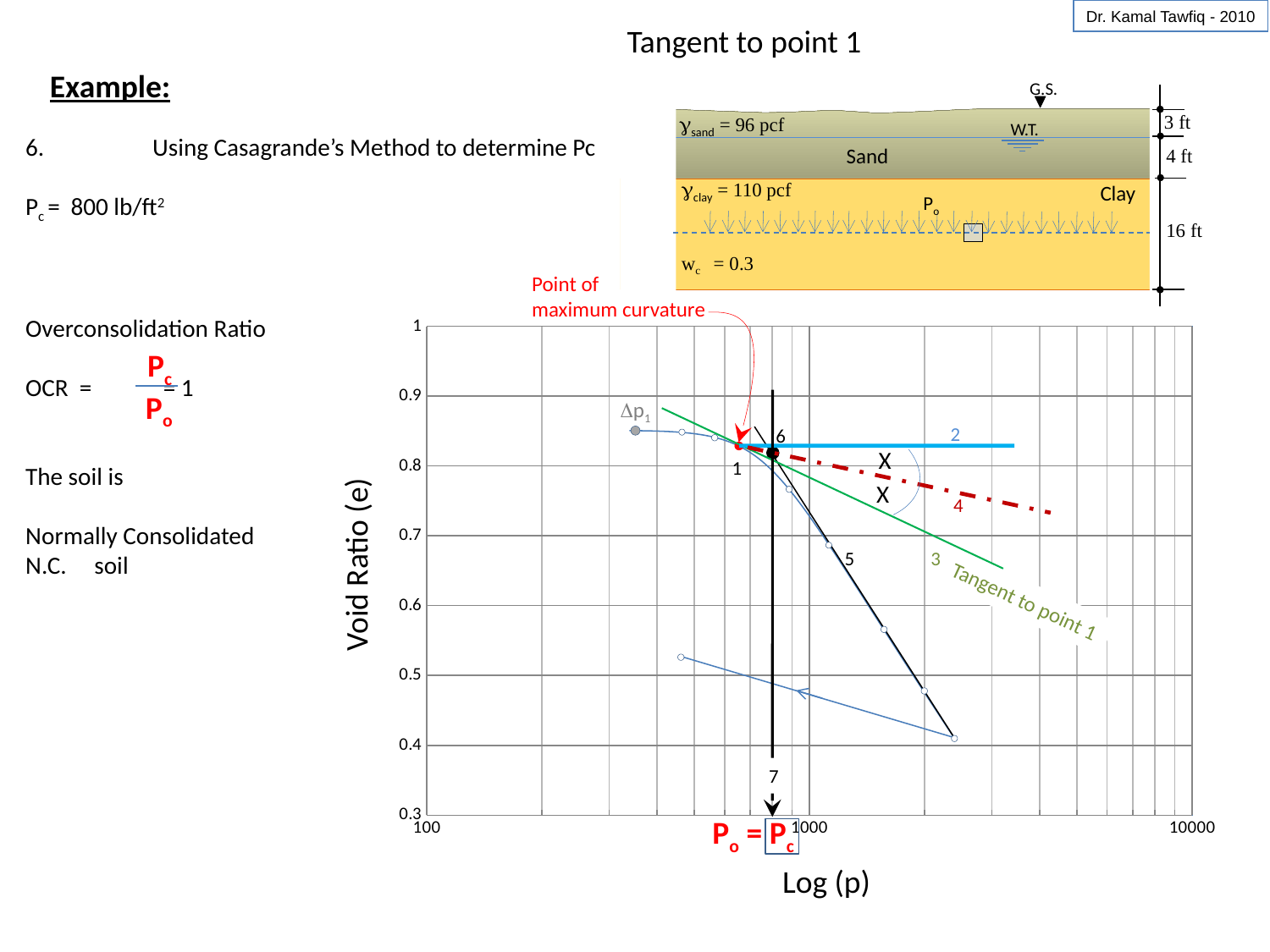
What kind of chart is shown on the slide? line chart Is the void ratio at the point labelled 1 greater or less than 0.9? less Is the void ratio at the point labelled Δp1 greater or less than 0.8? greater Which point has the higher void ratio, the point labelled Δp1 or the point labelled 5? Δp1 Is the void ratio at the lowest point of the loading curve greater or less than 0.5? less As p increases along the x axis, does the void ratio along the main loading curve rise or fall? fall What is the label of the vertical axis of the chart? Void Ratio (e) What is the label of the horizontal axis of the chart? Log (p) What is the highest tick value shown on the vertical axis of the chart? 1